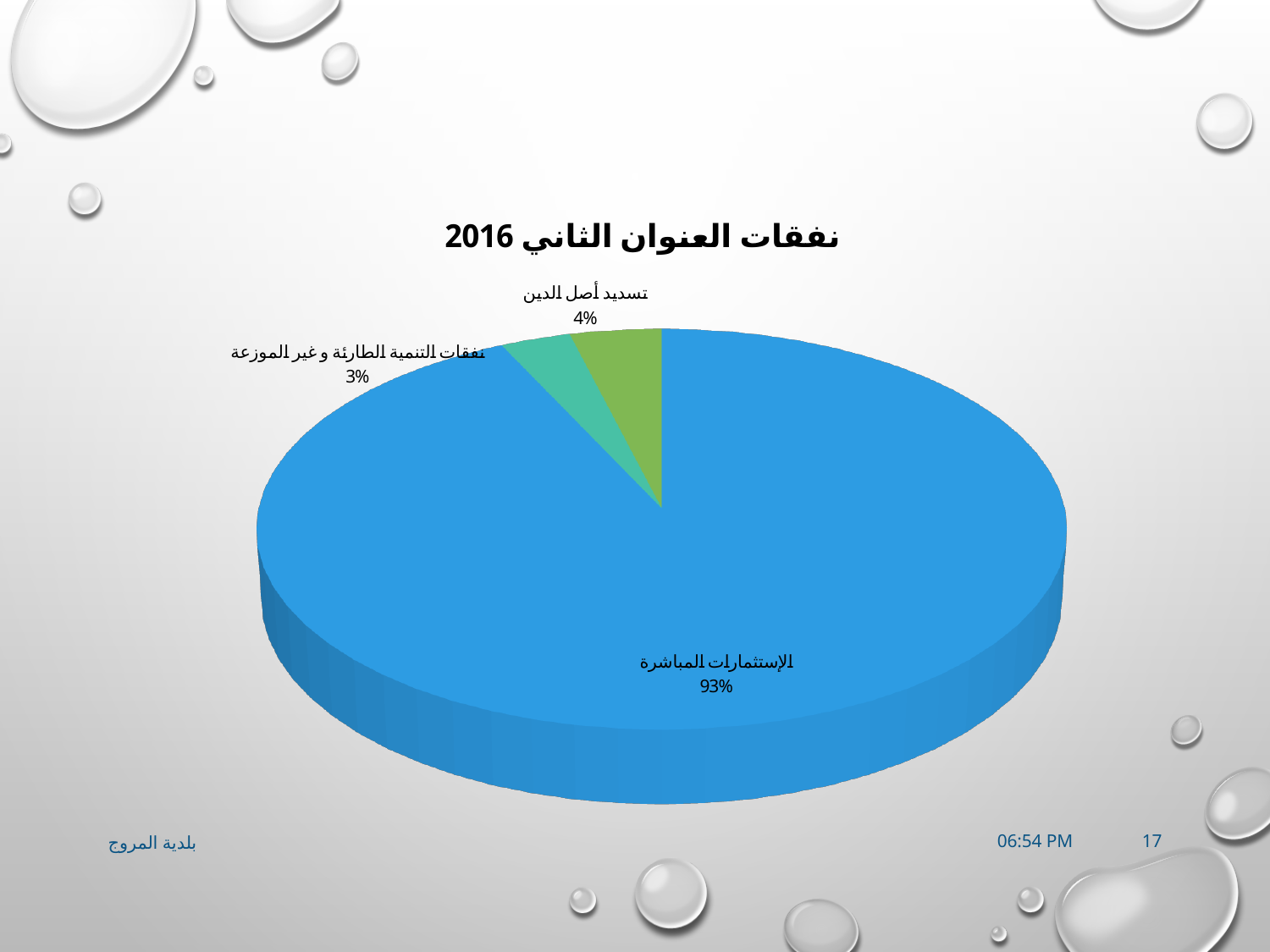
What colour is the slice for الإستثمارات المباشرة? blue What share of the pie does نفقات التنمية الطارئة و غير الموزعة represent? 3% What is the combined share of تسديد أصل الدين and نفقات التنمية الطارئة و غير الموزعة? 7% What is the difference in percentage points between الإستثمارات المباشرة and تسديد أصل الدين? 89 Which category has the largest slice of the pie? الإستثمارات المباشرة What is the title of the chart? نفقات العنوان الثاني 2016 What kind of chart is shown on the slide? pie chart Which is larger, the share for تسديد أصل الدين or the share for نفقات التنمية الطارئة و غير الموزعة? تسديد أصل الدين What share of the pie does تسديد أصل الدين represent? 4% Which category has the smallest slice of the pie? نفقات التنمية الطارئة و غير الموزعة How many slices does the pie chart have? 3 What share of the pie does الإستثمارات المباشرة represent? 93%